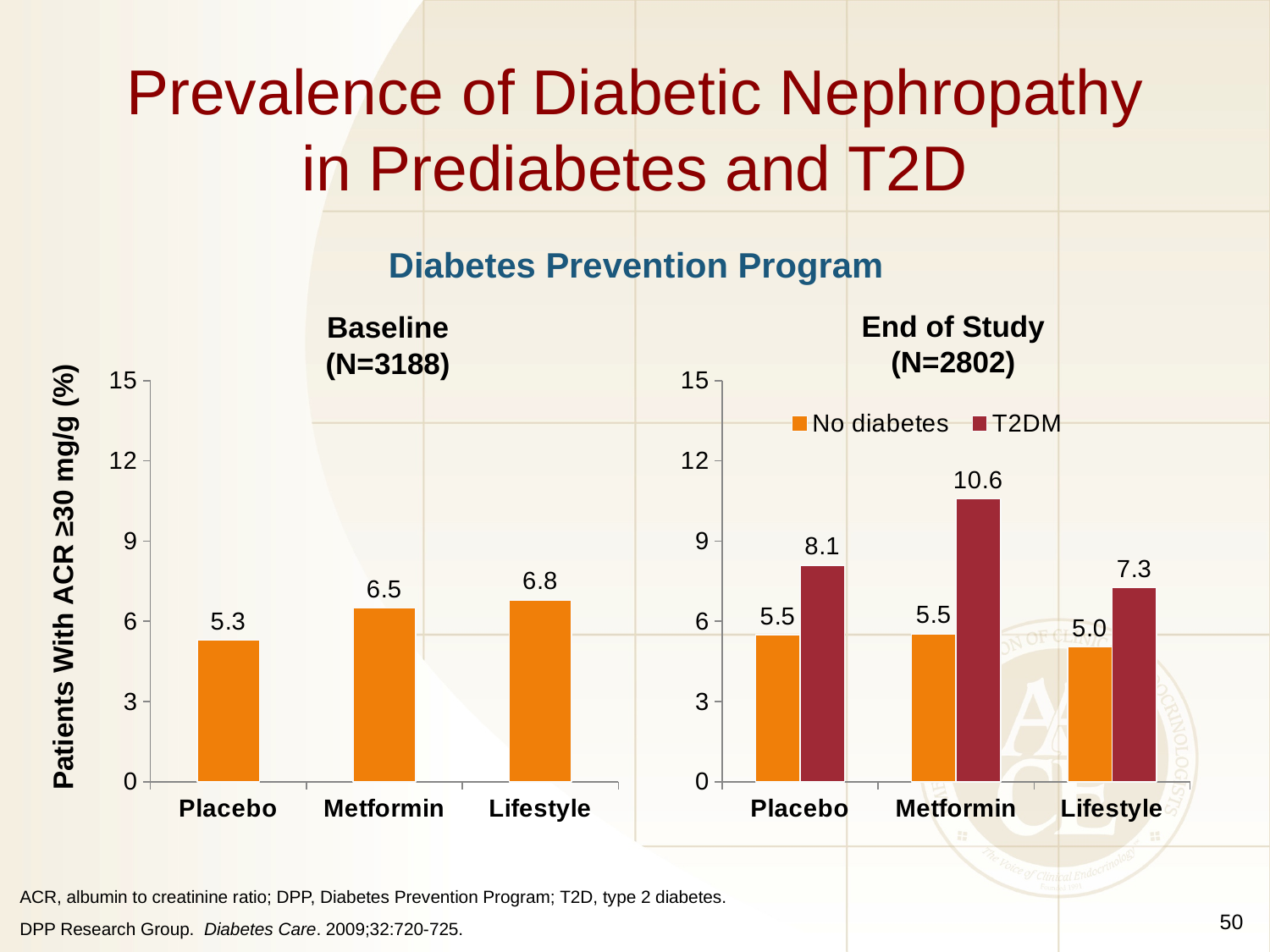
In the End of Study (N=2802) chart, what is the difference between the T2DM and No diabetes values for Placebo? 2.6 In the Baseline (N=3188) chart, what is the difference between the Lifestyle and Placebo values? 1.5 In the Baseline (N=3188) chart, which group has the lowest value? Placebo In the End of Study (N=2802) chart, what is the No diabetes value for Lifestyle? 5.0 How many series does the legend of the End of Study (N=2802) chart list? 2 In the End of Study (N=2802) chart, what is the T2DM value for Metformin? 10.6 In the End of Study (N=2802) chart, which group has the highest T2DM value? Metformin What type of chart is the Baseline (N=3188) chart? Bar chart In the Baseline (N=3188) chart, which group has the highest value? Lifestyle In the Baseline (N=3188) chart, what is the value for Metformin? 6.5 In the End of Study (N=2802) chart, is the T2DM value for Lifestyle larger or smaller than the T2DM value for Placebo? smaller How many groups are shown on the x axis of the Baseline (N=3188) chart? 3